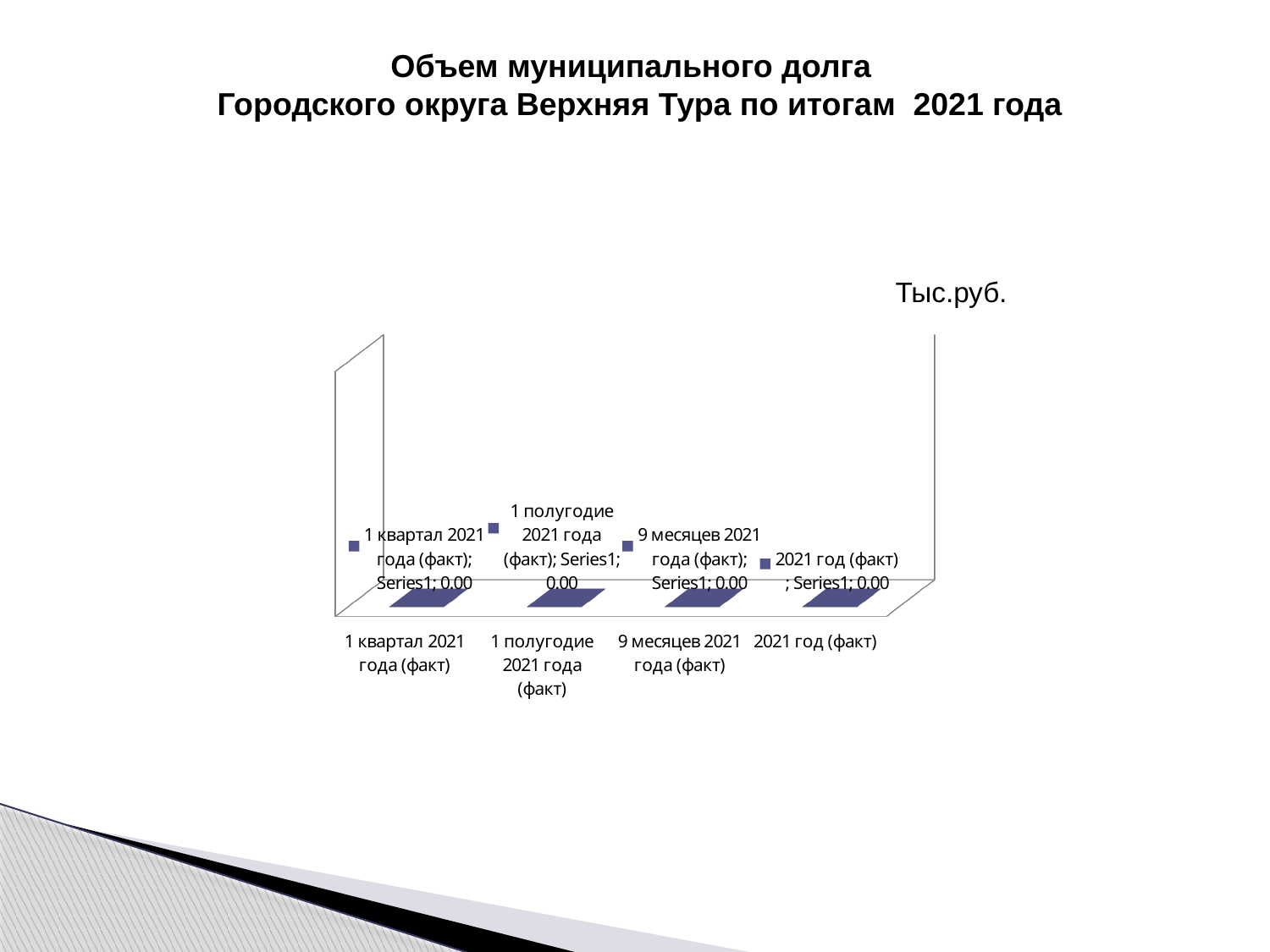
How many categories are shown on the x axis of the chart? 4 Do the values rise, fall, or stay the same from 1 квартал 2021 года (факт) to 2021 год (факт)? stay the same What is the value for 9 месяцев 2021 года (факт)? 0.00 What is the value for 2021 год (факт)? 0.00 What is the value for 1 квартал 2021 года (факт)? 0.00 What is the value for 1 полугодие 2021 года (факт)? 0.00 What kind of chart is shown on the slide? bar chart What is the title of the slide containing the chart? Объем муниципального долга Городского округа Верхняя Тура по итогам 2021 года What unit of measurement is indicated for the chart? Тыс.руб. What is the difference between the value for 2021 год (факт) and the value for 1 квартал 2021 года (факт)? 0.00